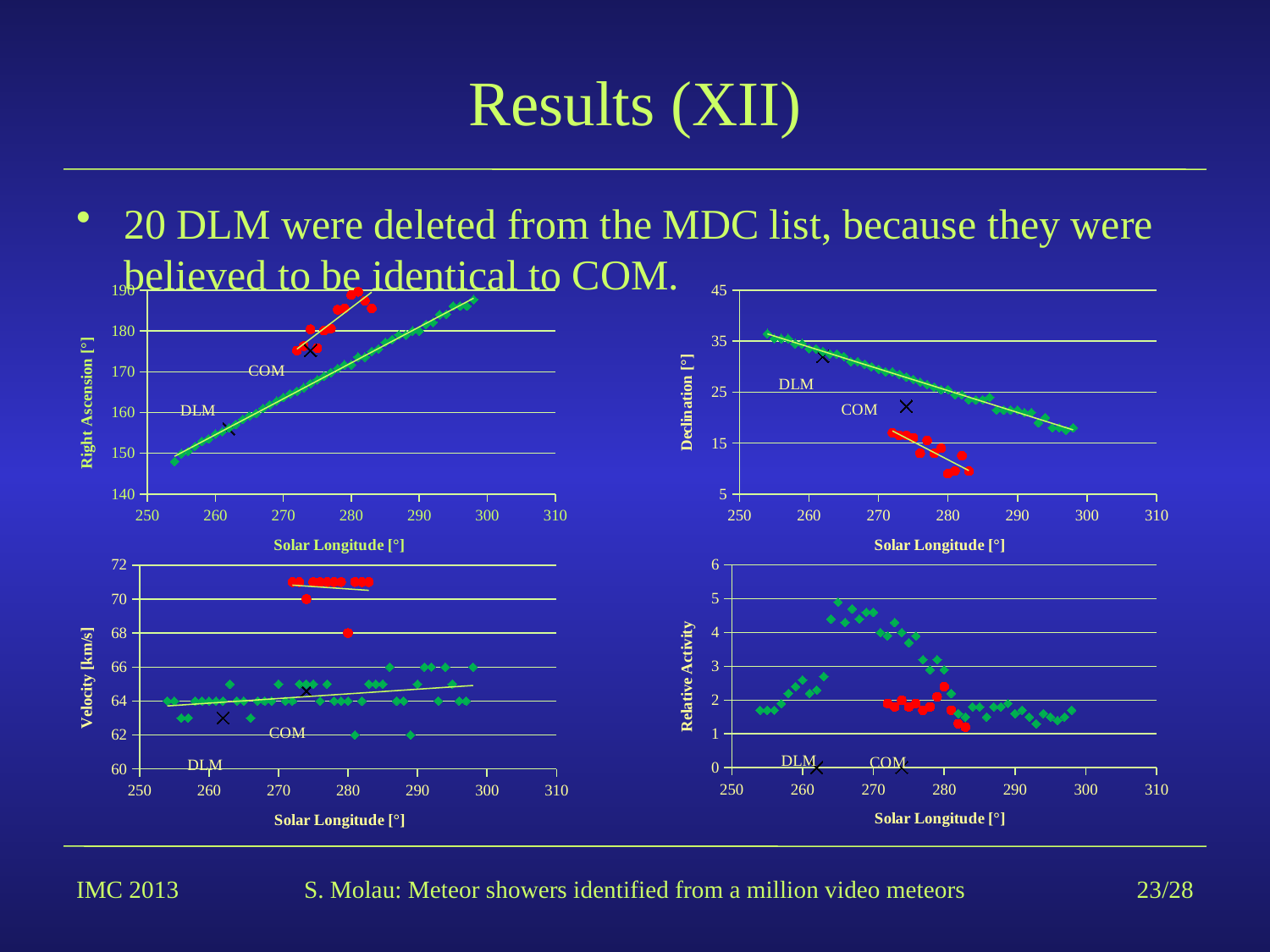
In the top-left chart (Right Ascension), is the DLM value at solar longitude 260 greater or less than 160? less In the bottom-right chart (Relative Activity), is the peak DLM value near solar longitude 265 greater or less than 4? greater In the top-left chart (Right Ascension), is the COM value at solar longitude 280 greater or less than 180? greater What is the x-axis label shared by all four charts on the slide? Solar Longitude [°] What kind of chart is the top-left chart (Right Ascension vs Solar Longitude)? scatter chart In the bottom-left chart (Velocity), which shower has the higher velocity, COM or DLM? COM In the top-right chart (Declination), do the green DLM values rise or fall as solar longitude increases? fall In the top-left chart (Right Ascension), do the green DLM values rise or fall as solar longitude increases? rise